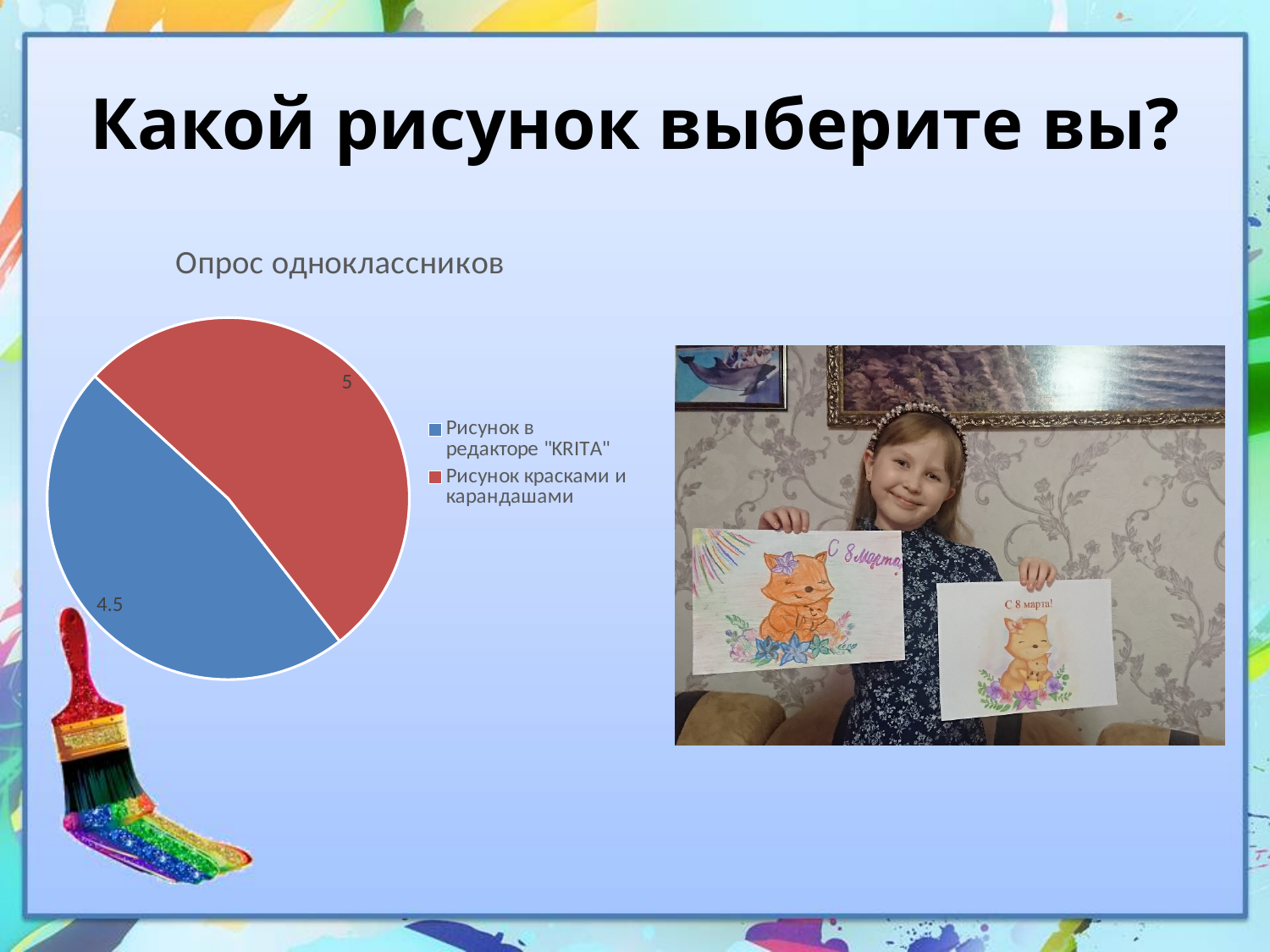
How many categories does the pie chart have? 2 Which category has the smallest slice of the pie? Рисунок в редакторе "KRITA" What is the value for "Рисунок красками и карандашами"? 5 What is the title of the chart? Опрос одноклассников What is the value for "Рисунок в редакторе "KRITA""? 4.5 What is the difference between the value for "Рисунок красками и карандашами" and the value for "Рисунок в редакторе "KRITA""? 0.5 What colour is the slice for "Рисунок в редакторе "KRITA""? blue What is the total of all slices in the pie chart? 9.5 Which category has the largest slice of the pie? Рисунок красками и карандашами Which is larger: the value for "Рисунок в редакторе "KRITA"" or the value for "Рисунок красками и карандашами"? Рисунок красками и карандашами What type of chart is shown on the slide? pie chart How many entries does the legend list? 2